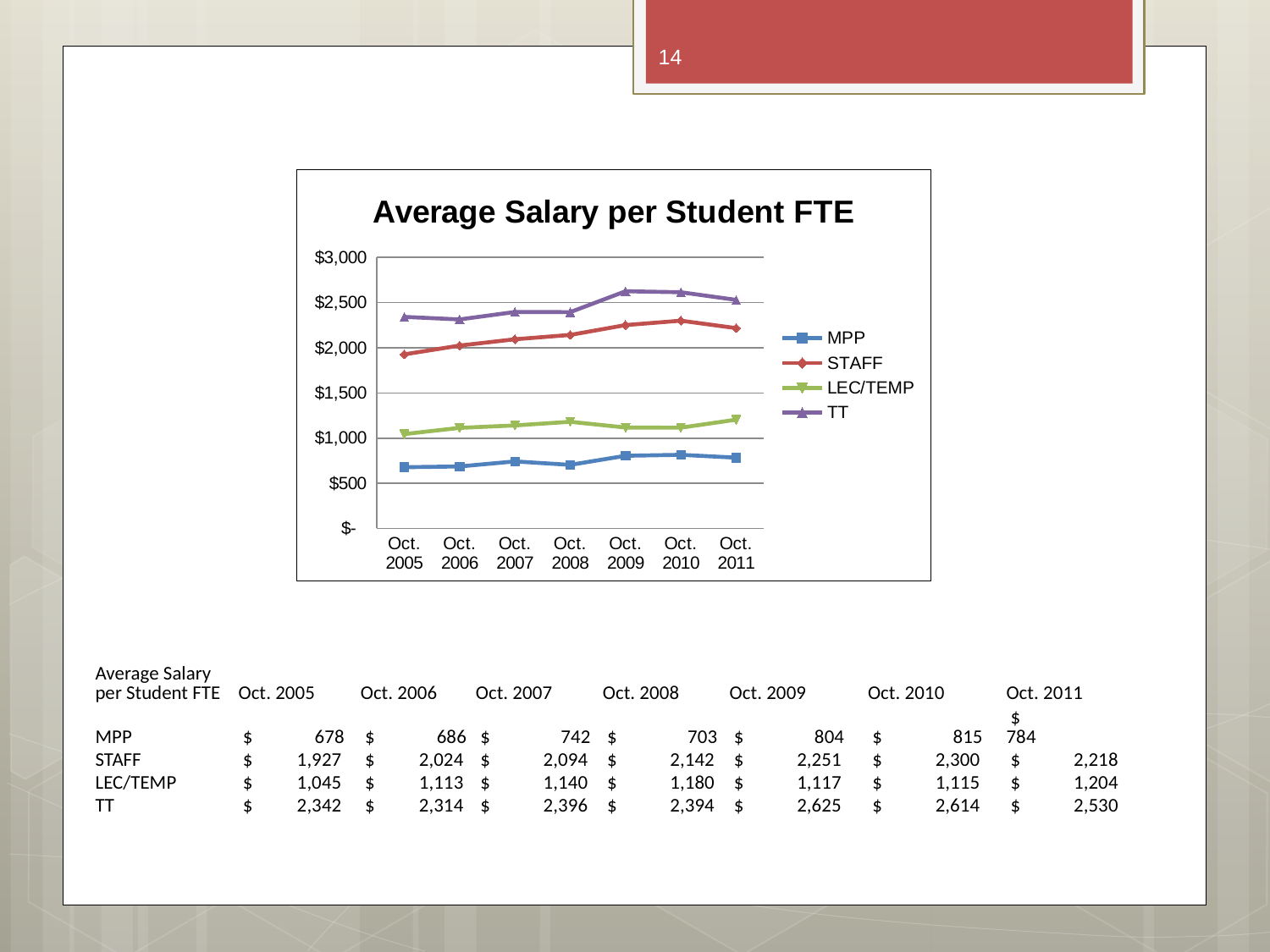
What is the difference between the TT value and the STAFF value in Oct. 2011? $312 Which is larger, the LEC/TEMP value in Oct. 2008 or in Oct. 2009? Oct. 2008 How many series does the legend list? 4 How many time points are plotted along the x axis? 7 Is the TT value in Oct. 2009 greater or less than $2,500? greater What is the value for MPP in Oct. 2010? $815 Which series has the lowest values across all years? MPP What is the average salary per student FTE for STAFF in Oct. 2009? $2,251 What is the value for LEC/TEMP in Oct. 2011? $1,204 What is the title of the chart? Average Salary per Student FTE In which year does TT reach its highest value? Oct. 2009 What type of chart is shown on the slide? line chart